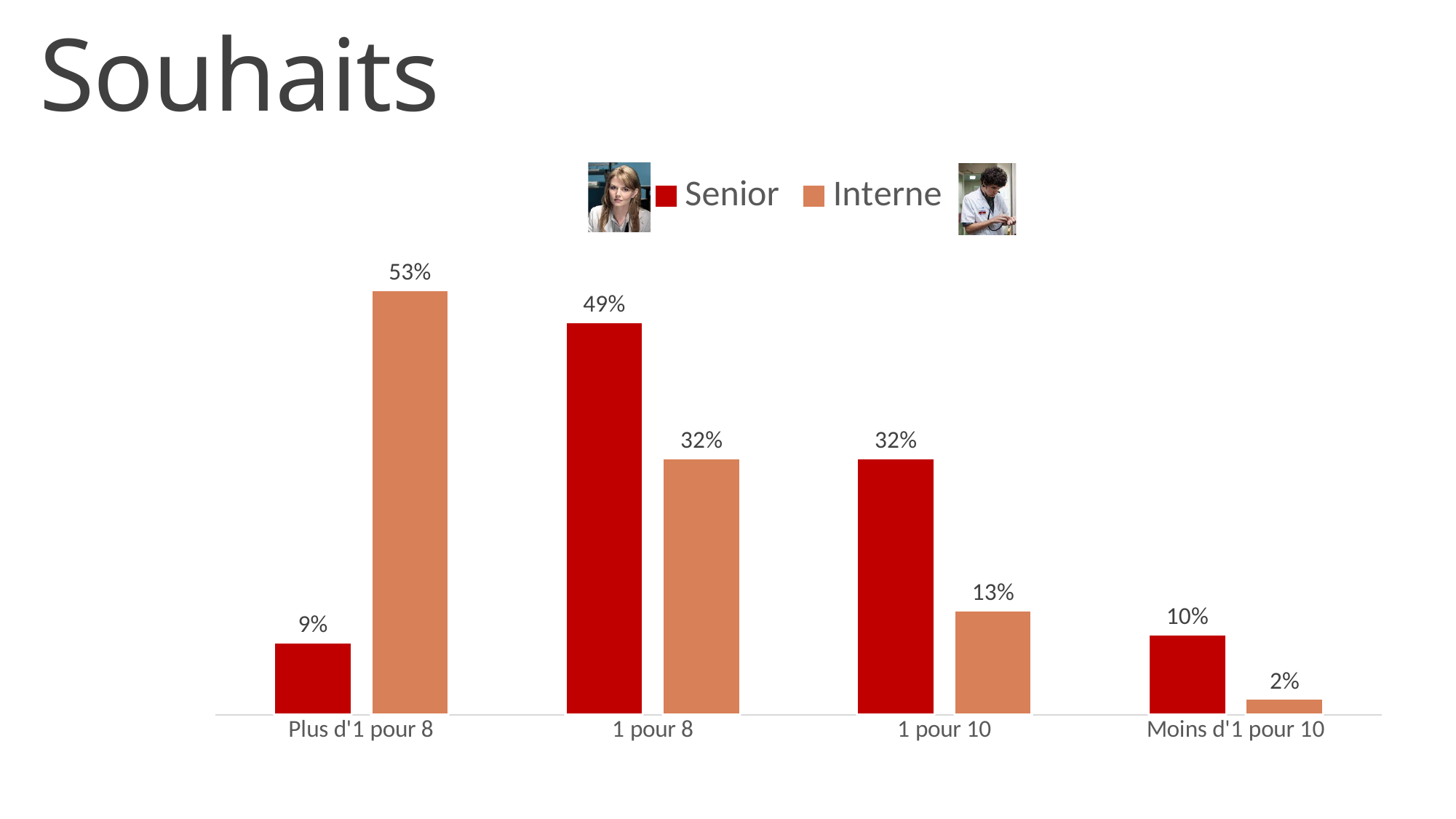
What is the Senior value for "1 pour 10"? 32% What kind of chart is shown on the slide? Bar chart What is the Senior value for "1 pour 8"? 49% Which category has the highest Senior value? 1 pour 8 What are the two series named in the legend? Senior and Interne How many categories are shown on the x axis? 4 How many series does the legend list? 2 What is the Interne value for "Moins d'1 pour 10"? 2% What is the Interne value for "Plus d'1 pour 8"? 53% What is the difference between the Interne and Senior values for "Plus d'1 pour 8"? 44% Which is larger for "1 pour 10": the Senior value or the Interne value? Senior Which category has the lowest Interne value? Moins d'1 pour 10